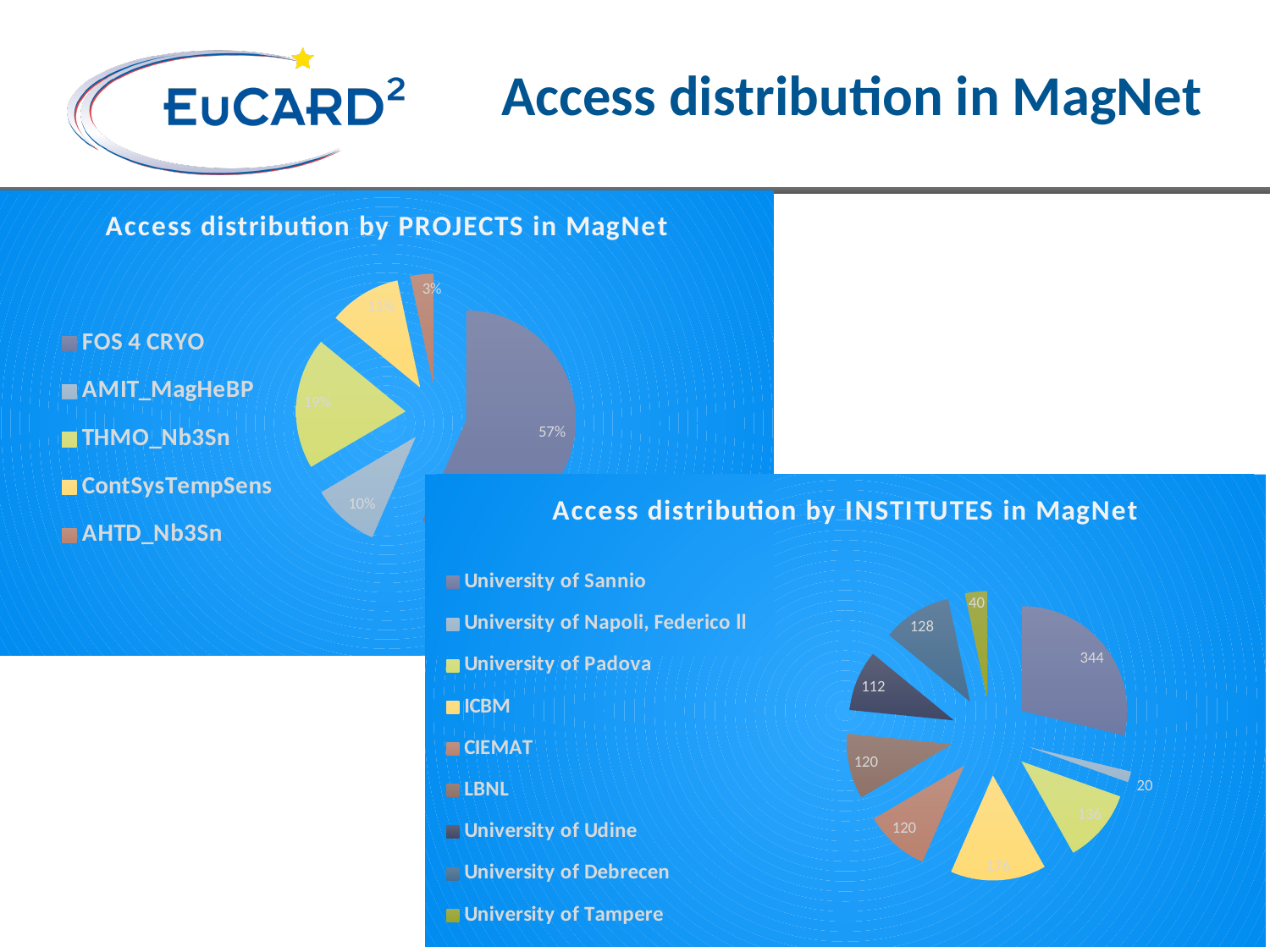
What type of chart is 'Access distribution by INSTITUTES in MagNet'? Pie chart In the 'Access distribution by INSTITUTES in MagNet' chart, what is the value for University of Sannio? 344 In the 'Access distribution by INSTITUTES in MagNet' chart, which institute has the smallest value? University of Napoli, Federico II In the 'Access distribution by PROJECTS in MagNet' chart, what share does AHTD_Nb3Sn have? 3% In the 'Access distribution by INSTITUTES in MagNet' chart, which is larger, the value for University of Debrecen or University of Udine? University of Debrecen In the 'Access distribution by INSTITUTES in MagNet' chart, what is the value for ICBM? 176 In the 'Access distribution by INSTITUTES in MagNet' chart, how many institutes are listed in the legend? 9 In the 'Access distribution by PROJECTS in MagNet' chart, what share does FOS 4 CRYO have? 57% In the 'Access distribution by PROJECTS in MagNet' chart, which project has the largest share? FOS 4 CRYO In the 'Access distribution by PROJECTS in MagNet' chart, how many projects are listed in the legend? 5 In the 'Access distribution by INSTITUTES in MagNet' chart, what is the difference between the values for University of Sannio and ICBM? 168 In the 'Access distribution by PROJECTS in MagNet' chart, which project has the smallest share? AHTD_Nb3Sn